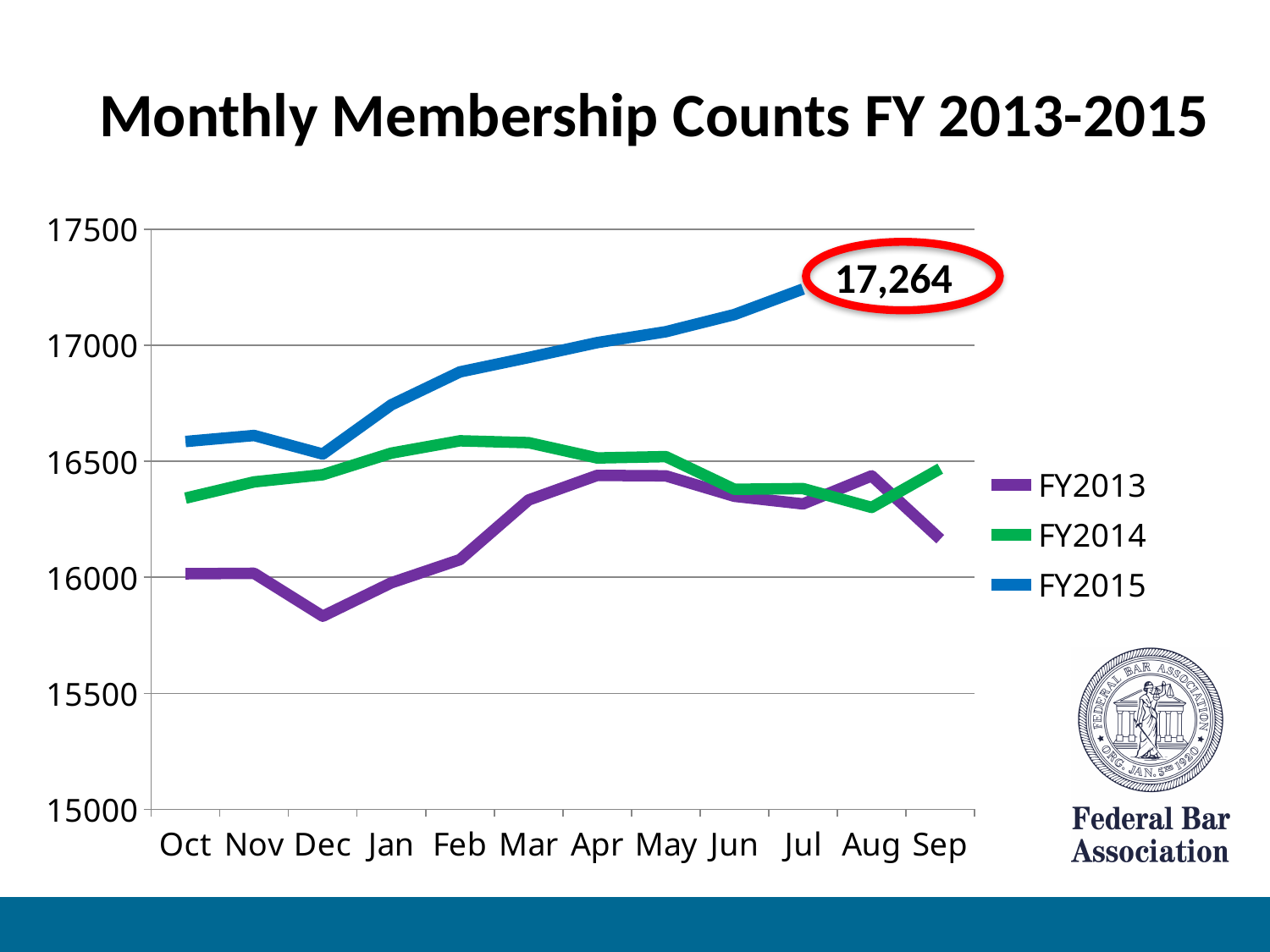
Does the FY2015 line rise or fall from Dec to Jul? rises Is the FY2015 value for Jan greater or less than 16500? greater Is the FY2014 value for Oct greater or less than 16500? less How many series does the legend list? 3 What is the title of the chart? Monthly Membership Counts FY 2013-2015 Which fiscal year has the lowest membership count in Oct? FY2013 What is the labelled membership count for FY2015 in Jul? 17,264 Which fiscal year has the highest membership count in Jul? FY2015 In Oct, which is larger: the FY2015 value or the FY2013 value? FY2015 How many months are shown along the x axis? 12 Is the FY2013 value for Dec greater or less than 16000? less What kind of chart is shown on the slide? line chart